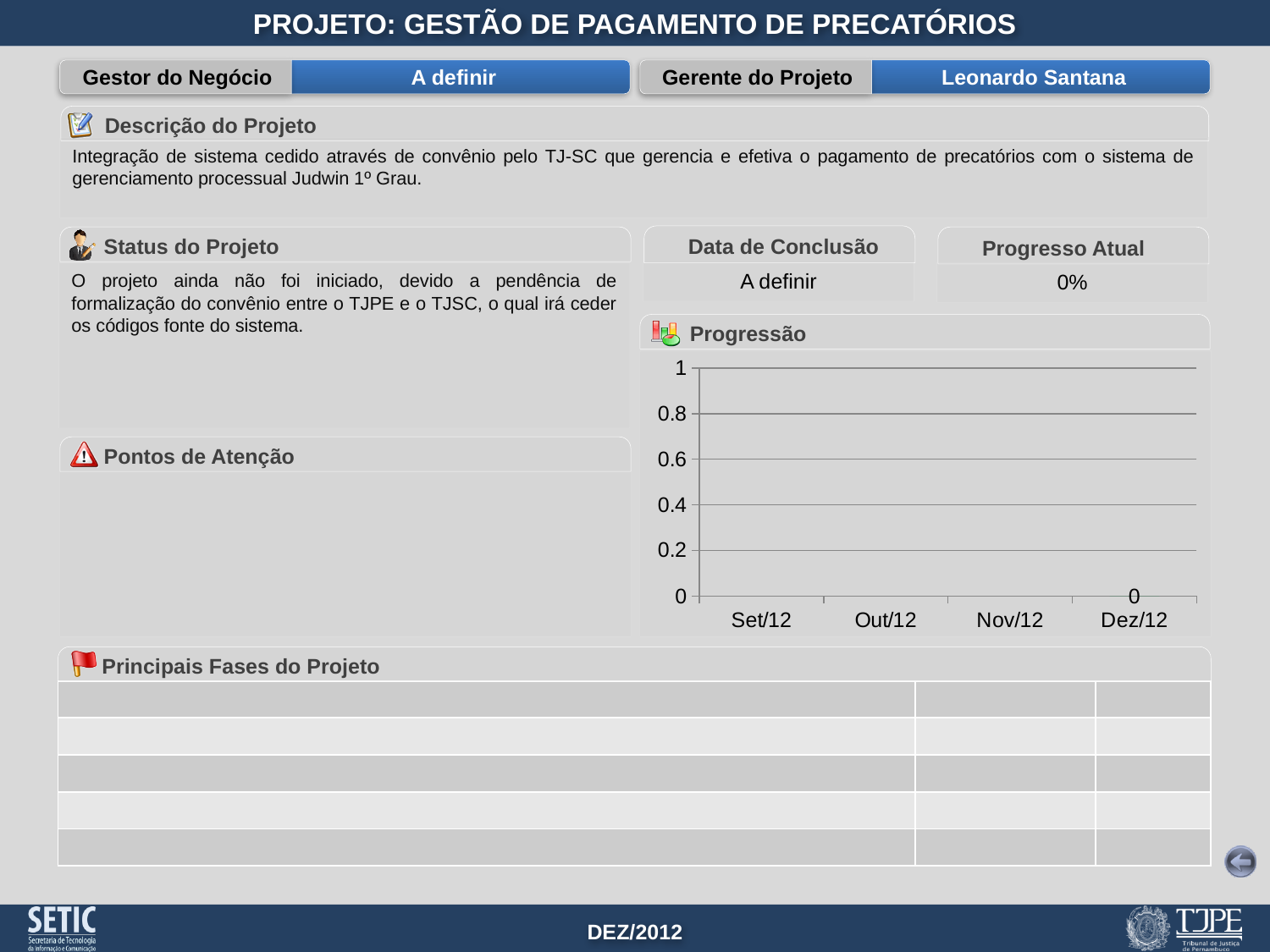
What is the first category on the x axis of the Progressão chart? Set/12 What is the highest value shown on the y axis of the Progressão chart? 1 What value is labelled for Dez/12 in the Progressão chart? 0 How many categories are shown on the x axis of the Progressão chart? 4 What is the last category on the x axis of the Progressão chart? Dez/12 Is the value for Dez/12 in the Progressão chart greater or less than 0.2? less What is the title of the chart on the slide? Progressão